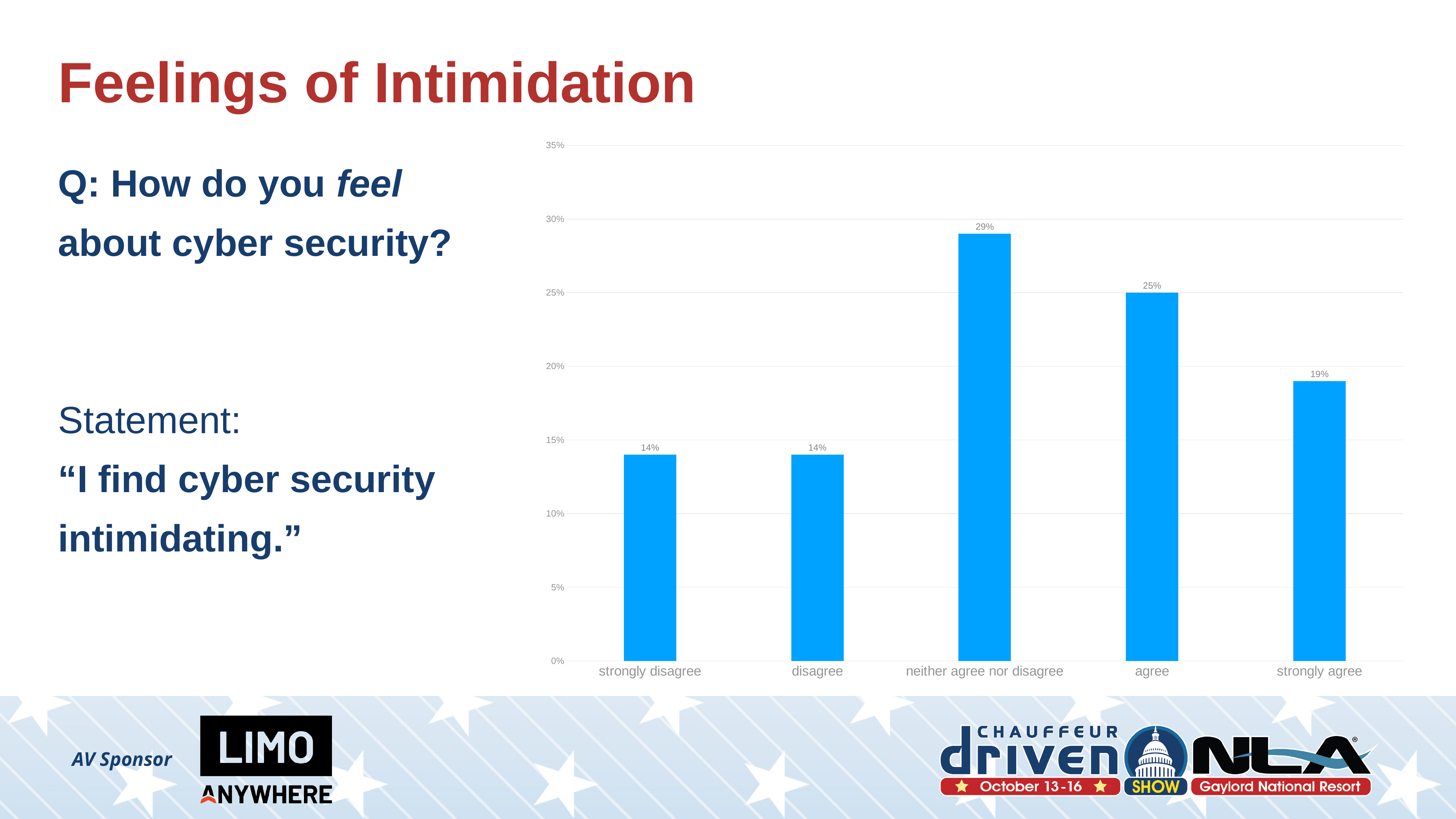
How many response categories are shown on the x axis? 5 What is the difference between the values for "neither agree nor disagree" and "disagree"? 15% What kind of chart is shown on the slide? bar chart Is the value for "strongly disagree" greater or less than 15%? less What is the value for "strongly agree"? 19% What percentage of respondents answered "neither agree nor disagree"? 29% Do the values for "strongly disagree" and "disagree" differ? No, both are 14% Which is larger, the value for "agree" or the value for "strongly agree"? agree What is the difference between the values for "agree" and "strongly agree"? 6% What is the value for "agree"? 25% Which response category has the highest value? neither agree nor disagree What is the highest value shown on the y axis? 35%